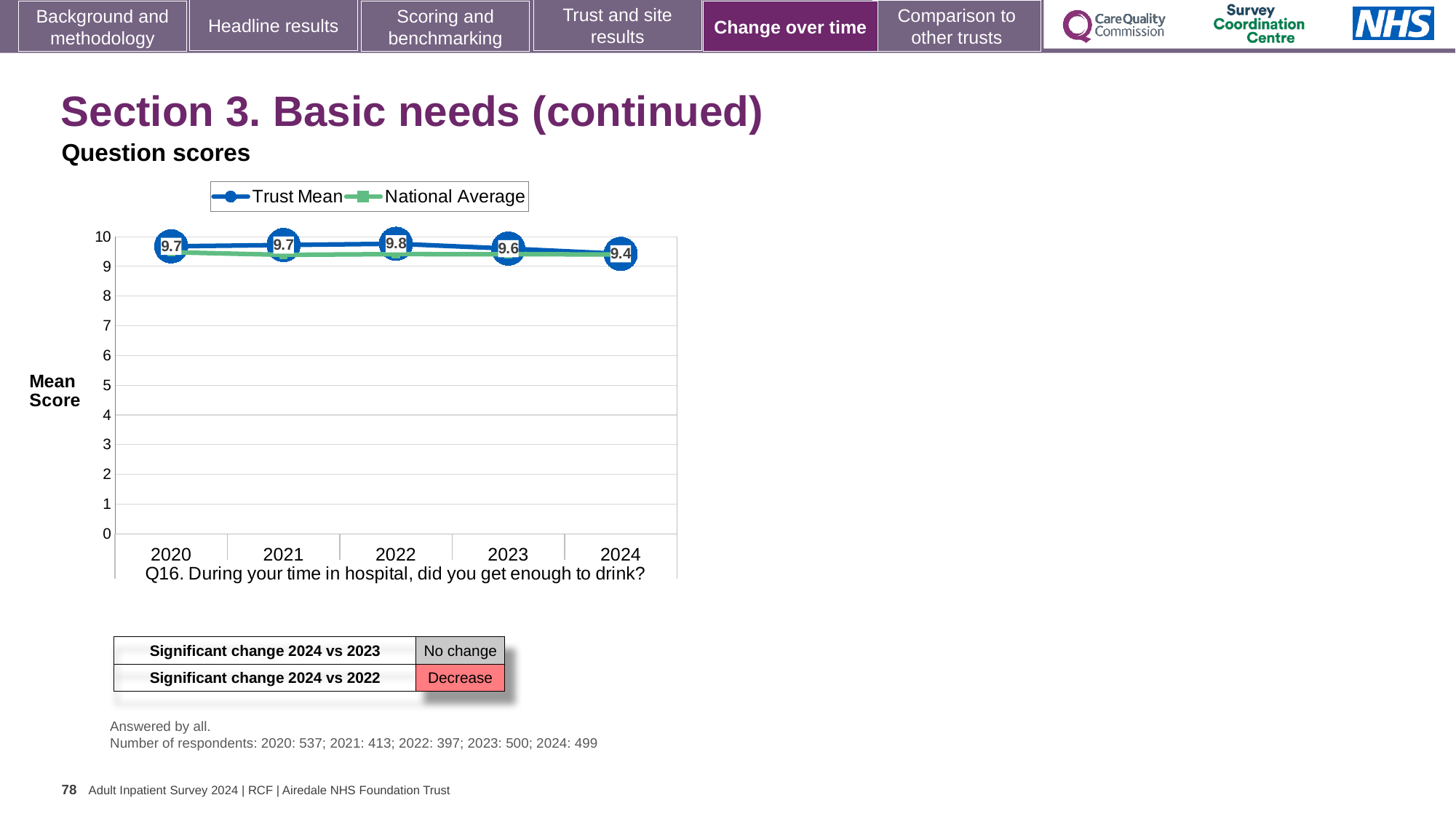
What is the Trust Mean score for 2020? 9.7 Is the National Average value for 2020 greater or less than 9? greater How many years are plotted on the x axis? 5 What kind of chart is shown? Line chart Does the Trust Mean rise or fall from 2022 to 2024? Fall What is the Trust Mean score for 2024? 9.4 What is the Trust Mean score for 2022? 9.8 Which year has the larger Trust Mean, 2020 or 2024? 2020 In which year is the Trust Mean lowest? 2024 In which year is the Trust Mean highest? 2022 What is the difference between the Trust Mean in 2022 and in 2024? 0.4 How many series does the legend list? 2